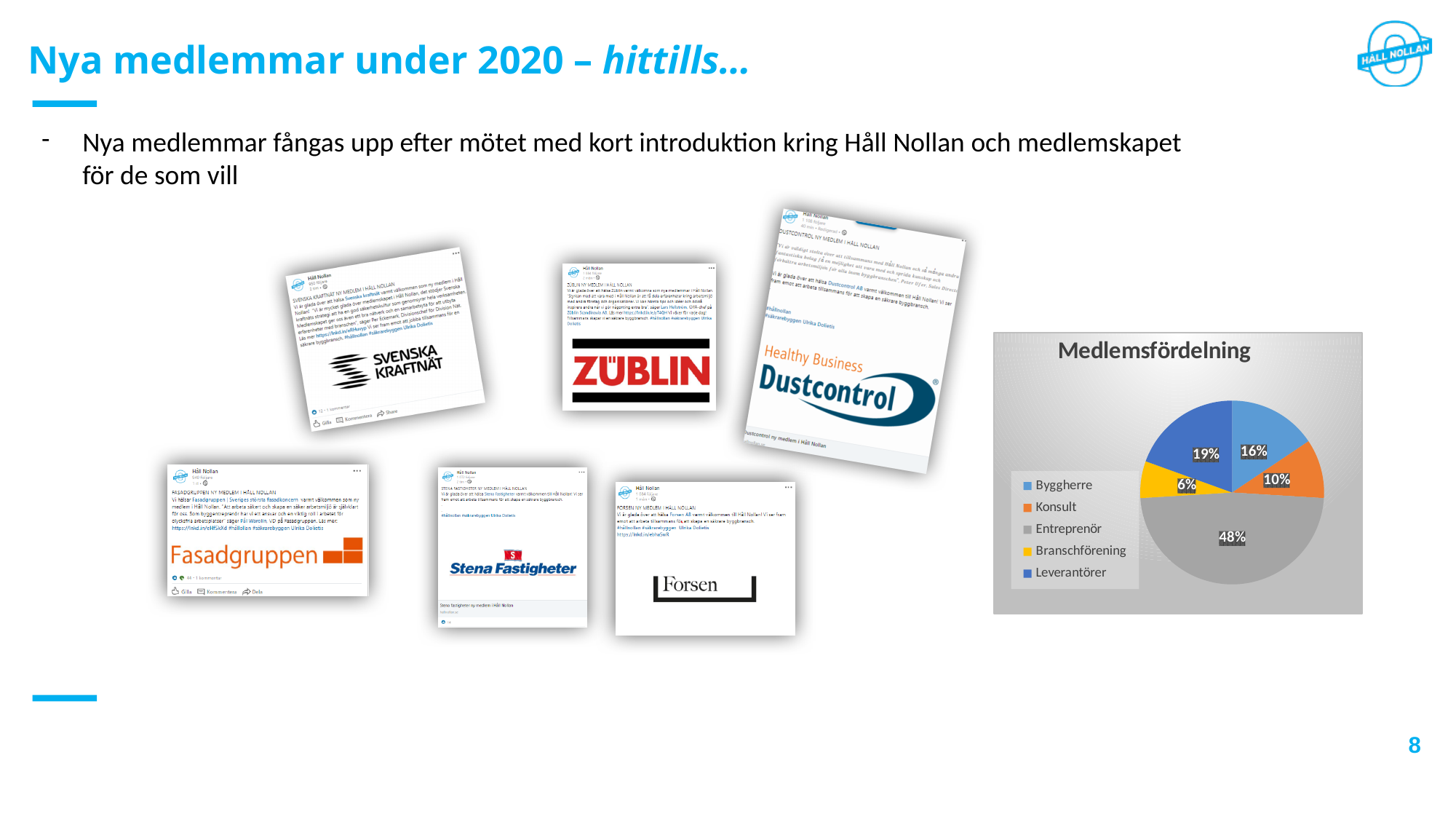
Which has a larger share, Konsult or Byggherre? Byggherre What is the difference in percentage points between Entreprenör and Leverantörer? 29 percentage points What share of the pie does Branschförening have? 6% Which colour represents Konsult in the pie chart? Orange How many categories does the pie chart show? 5 What share of the pie does Byggherre have? 16% What share of the pie does Entreprenör have? 48% What type of chart is shown under the title "Medlemsfördelning"? Pie chart Which category has the largest share of the pie? Entreprenör What is the title of the chart on the slide? Medlemsfördelning Which category has the smallest share of the pie? Branschförening What share of the pie does Leverantörer have? 19%